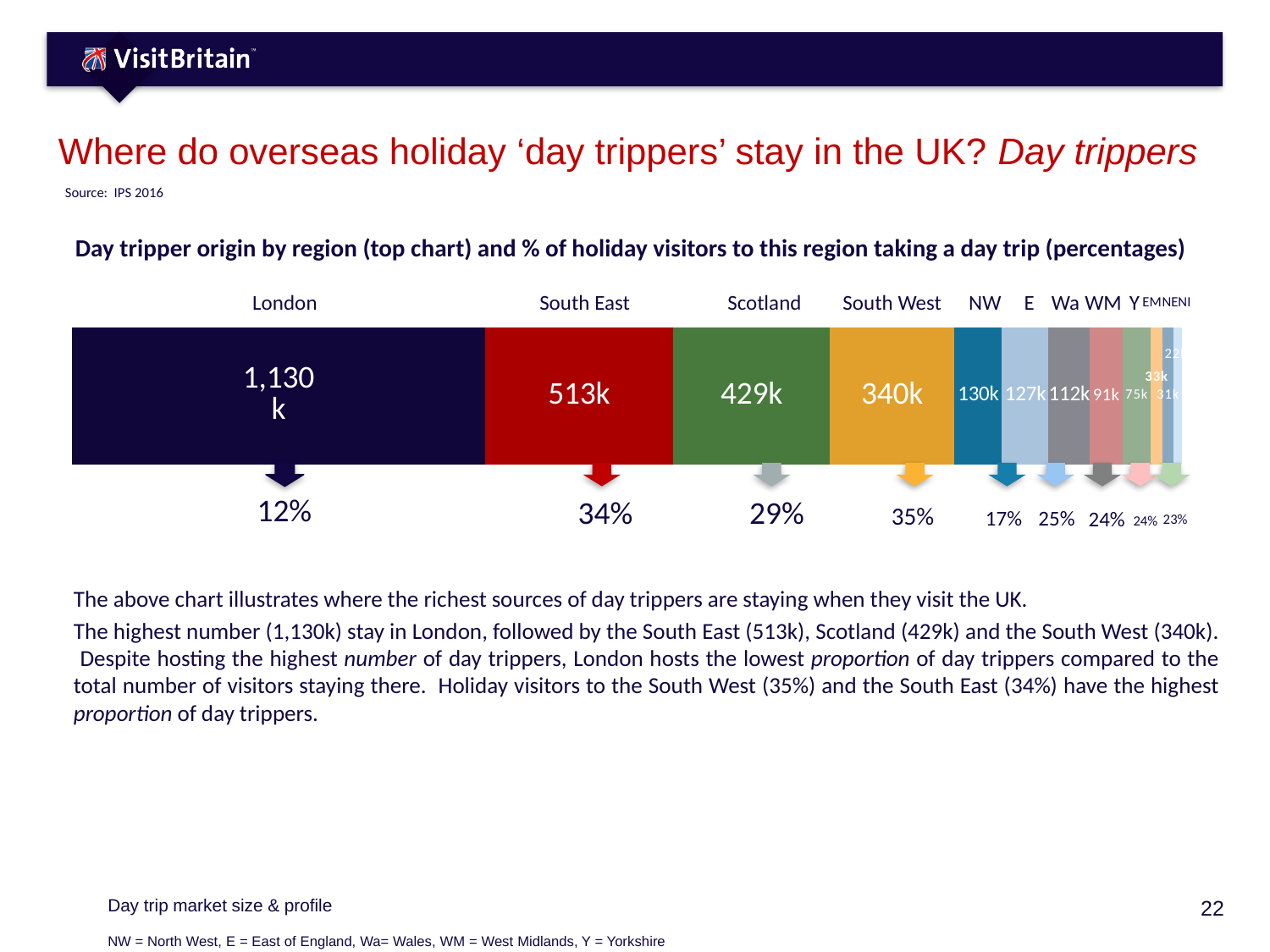
What value is shown for Scotland in the day tripper origin chart? 429k Which region has the highest number of day trippers? London Which region has the lowest percentage of holiday visitors taking a day trip? London Which region has a higher percentage of holiday visitors taking a day trip, London or the South East? South East What is the difference between the number of day trippers staying in London and in the South East? 617k What kind of chart is used to show day tripper origin by region? bar chart What is the difference between the day tripper numbers for Scotland and the South West? 89k How many day trippers stay in London according to the chart? 1,130k What is the number of day trippers shown for the South East? 513k Which has more day trippers, Scotland or the South West? Scotland What percentage of holiday visitors to the South West take a day trip? 35% What percentage of holiday visitors to NW (North West) take a day trip? 17%